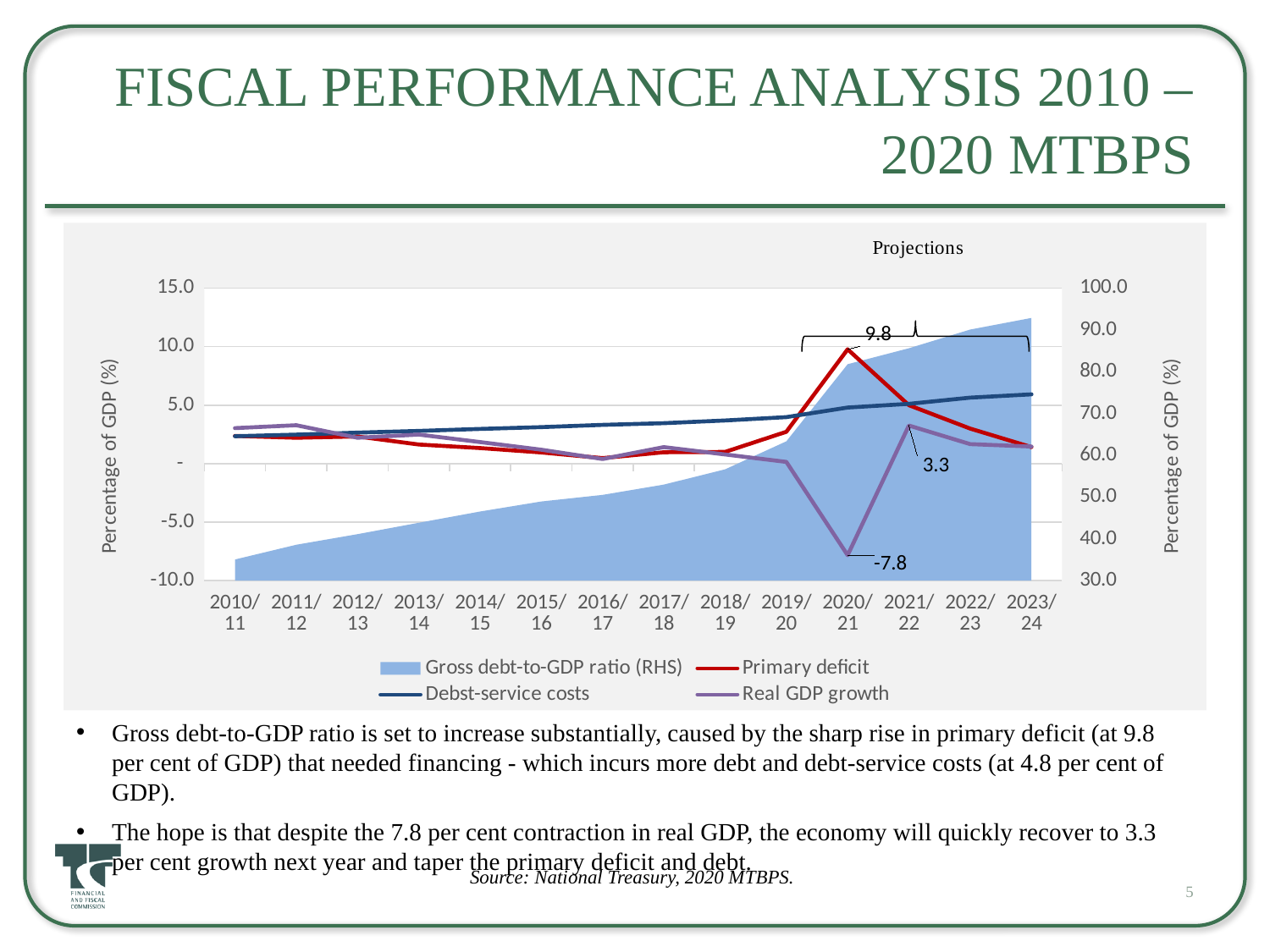
What is the value of the Primary deficit in 2020/21? 9.8 In which year is the Primary deficit highest? 2020/21 By how much does Real GDP growth change from 2020/21 to 2021/22? 11.1 What kind of chart is this? Combined area and line chart How many fiscal years are shown on the x axis? 14 Is the Gross debt-to-GDP ratio in 2010/11 greater or less than 40.0? less What is the value of Real GDP growth in 2020/21? -7.8 Do Debt-service costs rise or fall from 2010/11 to 2023/24? rise What is the value of Real GDP growth in 2021/22? 3.3 How many series does the legend list? 4 In which year is Real GDP growth lowest? 2020/21 Is the Gross debt-to-GDP ratio in 2023/24 greater or less than 80.0? greater